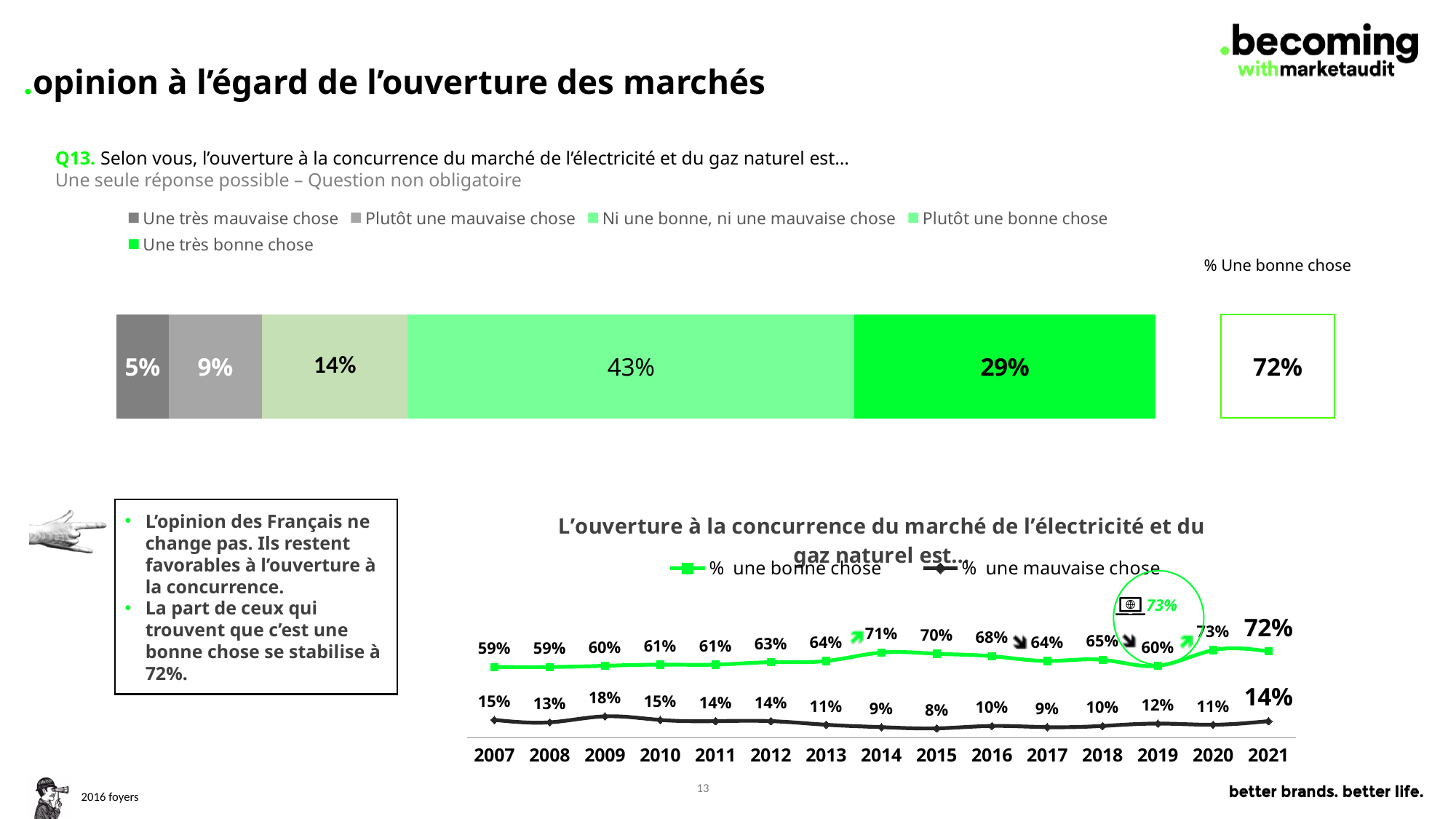
In the bottom line chart, what is the value of '% une bonne chose' in 2014? 71% In the top stacked bar chart, how many categories does the legend list? 5 In the bottom line chart, in which year is '% une mauvaise chose' lowest? 2015 What type of chart is the bottom chart? Line chart In the bottom line chart, what is the difference between '% une bonne chose' in 2019 and in 2020? 13% In the top stacked bar chart, what percentage corresponds to 'Plutôt une bonne chose'? 43% In the top stacked bar chart, what percentage corresponds to 'Une très mauvaise chose'? 5% In the bottom line chart, what is the value of '% une mauvaise chose' in 2021? 14% In the top stacked bar chart, what is the difference between 'Plutôt une bonne chose' and 'Une très bonne chose'? 14% In the bottom line chart, how many years are shown on the x axis? 15 In the bottom line chart, in which year is '% une bonne chose' highest? 2020 In the bottom line chart, in which year is '% une mauvaise chose' highest? 2009